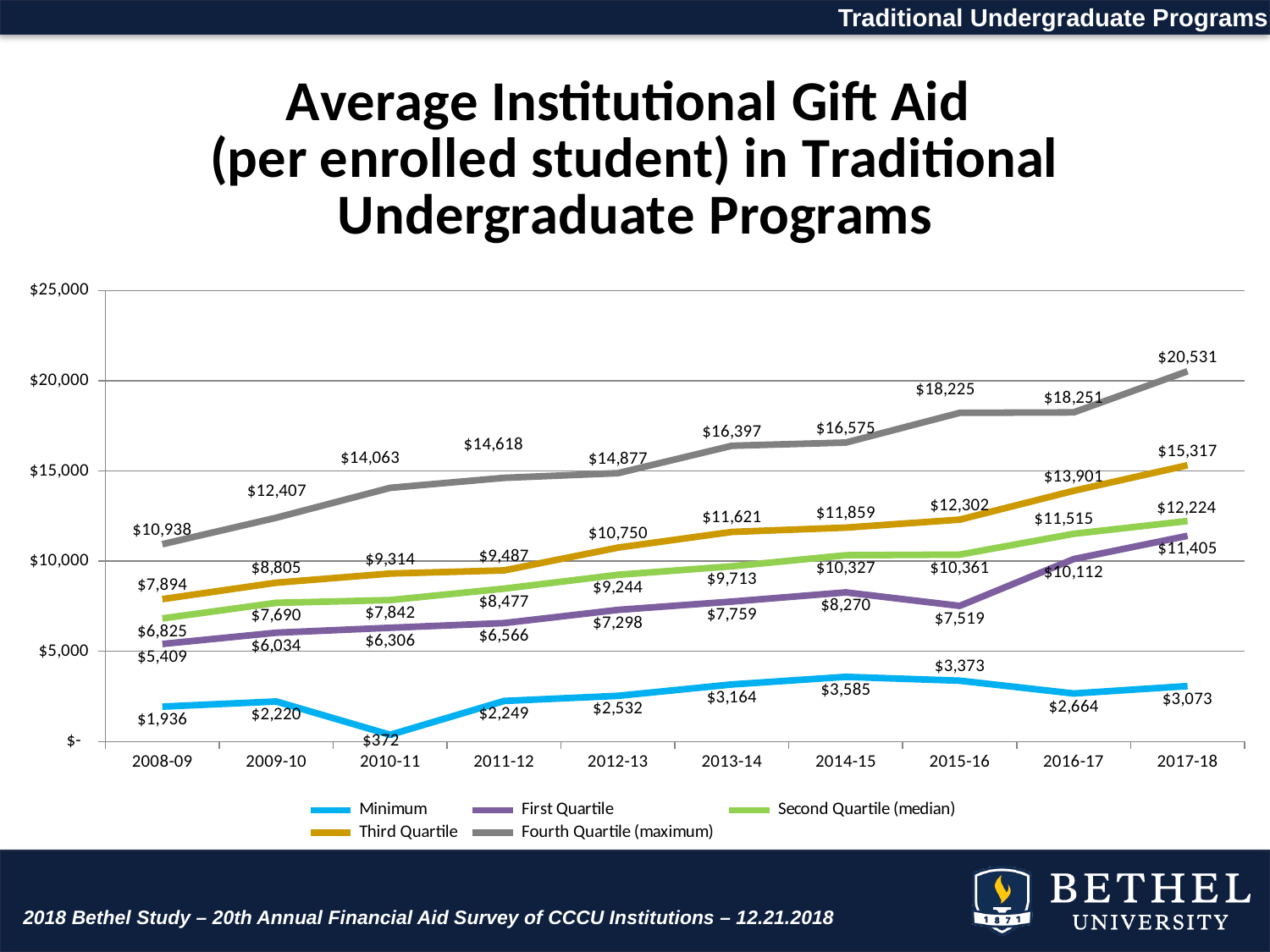
Does the Fourth Quartile (maximum) series generally rise or fall from 2008-09 to 2017-18? Rise What type of chart is shown on the slide? Line chart How many academic years are plotted along the x axis? 10 In which year is the Minimum series at its lowest? 2010-11 What is the Fourth Quartile (maximum) value for 2017-18? $20,531 In which year is the Third Quartile series at its highest? 2017-18 What is the title of the chart? Average Institutional Gift Aid (per enrolled student) in Traditional Undergraduate Programs Which is larger, the First Quartile value in 2014-15 or in 2015-16? 2014-15 What is the Minimum value for 2010-11? $372 How many series does the legend list? 5 What is the Second Quartile (median) value for 2013-14? $9,713 What is the difference between the Fourth Quartile (maximum) and Third Quartile values in 2017-18? $5,214